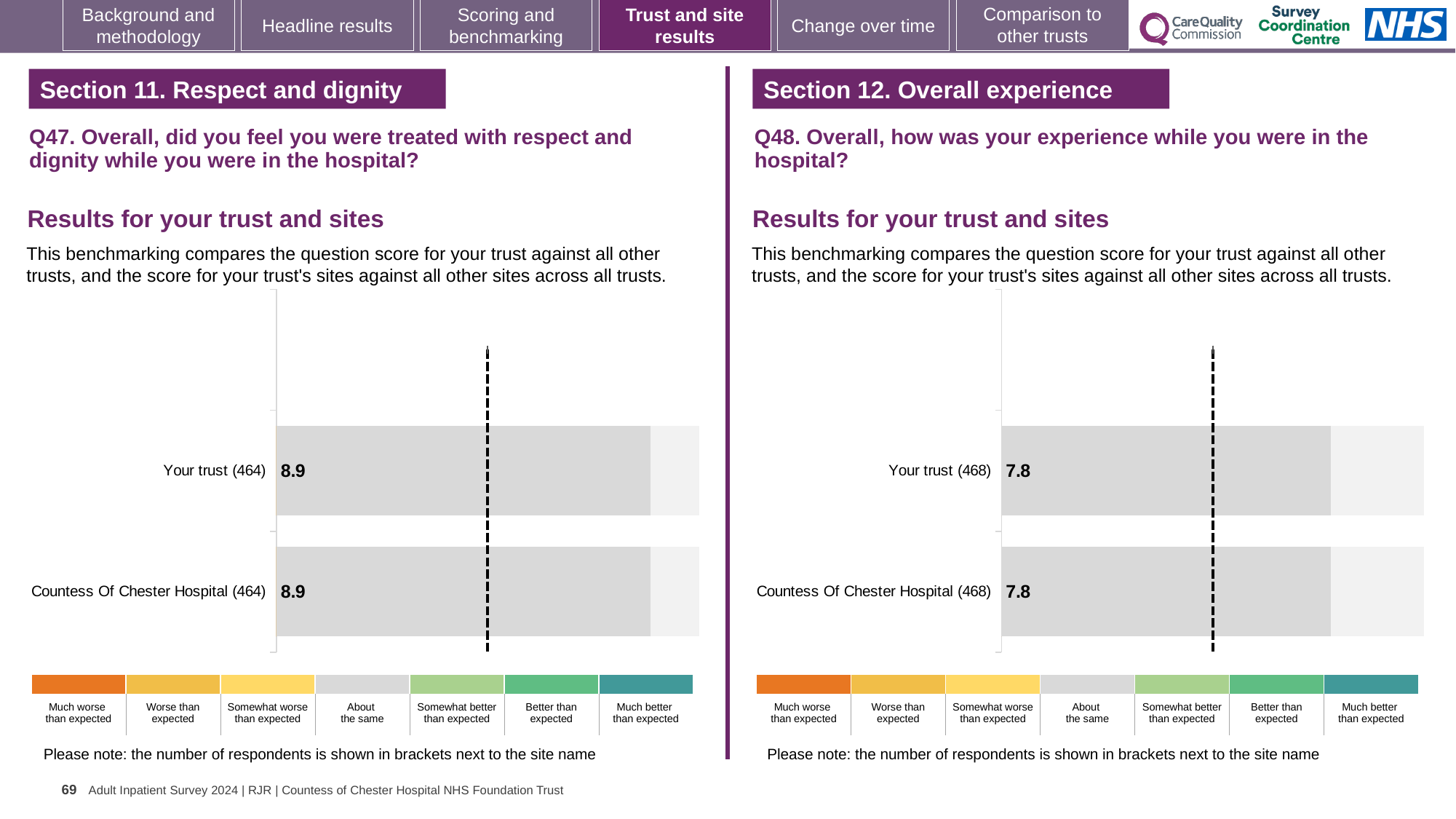
In the Q48 chart on the right, what is the score for Your trust? 7.8 In the Q47 chart on the left, what is the score for Countess Of Chester Hospital? 8.9 In the Q47 chart on the left, how many respondents are shown in brackets for Your trust? 464 How many bars are plotted in the Q47 chart on the left? 2 In the Q47 chart on the left, is the score for Your trust the same as the score for Countess Of Chester Hospital? Yes What is the difference between the Your trust score in the Q47 chart on the left and the Your trust score in the Q48 chart on the right? 1.1 In the Q48 chart on the right, what is the score for Countess Of Chester Hospital? 7.8 In the Q47 chart on the left, what is the score for Your trust? 8.9 In the colour key below the Q48 chart on the right, what label is shown for the grey segment? About the same In the Q48 chart on the right, how many respondents are shown in brackets for Countess Of Chester Hospital? 468 What kind of chart is used for the Q48 results on the right? Bar chart Which is larger: the Your trust score in the Q47 chart on the left or the Your trust score in the Q48 chart on the right? Q47 chart (8.9)